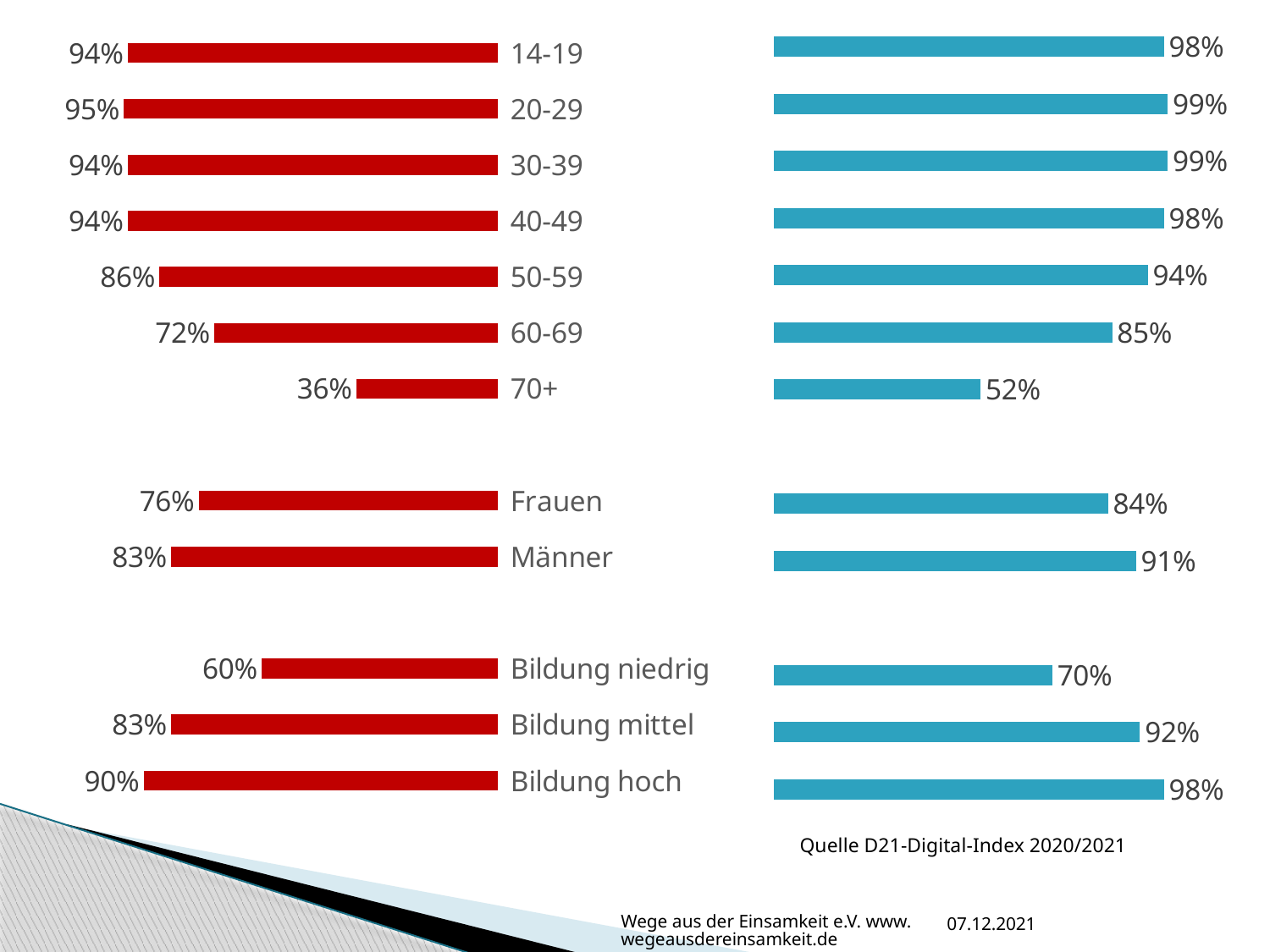
On the right (blue) chart, what is the value for the 60-69 age group? 85% On the right (blue) chart, what is the difference between the values for Bildung hoch and Bildung niedrig? 28% On the right (blue) chart, which is larger, the value for Männer or the value for Frauen? Männer On the left (red) chart, what is the value for Bildung niedrig? 60% On the left (red) chart, what is the value for the 70+ age group? 36% On the right (blue) chart, what is the value for Frauen? 84% On the left (red) chart, which age group has the lowest value? 70+ On the right (blue) chart, which of the three Bildung categories has the lowest value? Bildung niedrig On the left (red) chart, what is the difference between the values for Männer and Frauen? 7% How many age-group categories are shown on the left (red) chart? 7 On the left (red) chart, which age group has the highest value? 20-29 What type of chart is the right (blue) chart? Bar chart